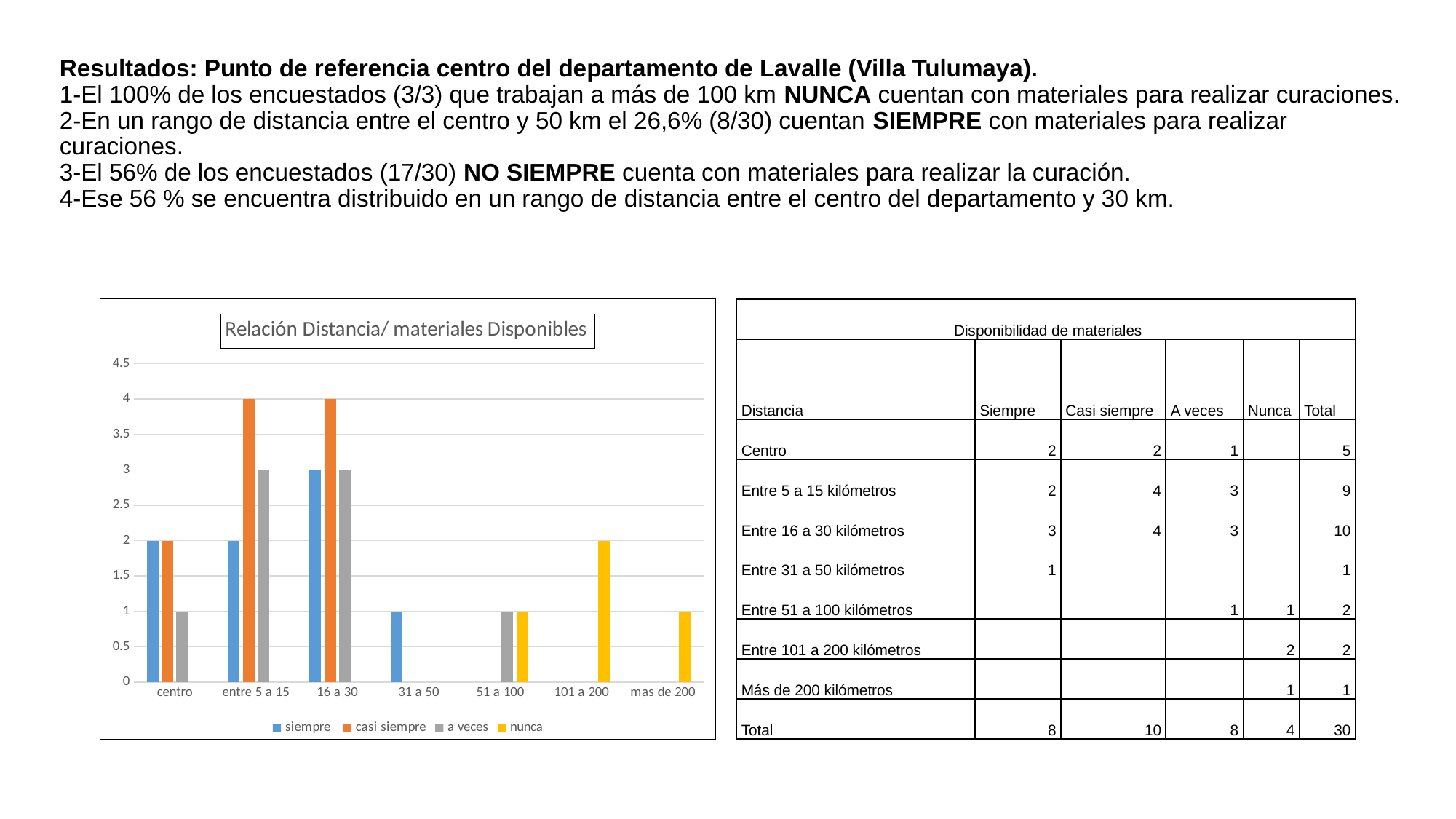
What is the value of the 'siempre' series for the '16 a 30' category? 3 How many series does the chart legend list? 4 Which is larger for the '16 a 30' category: the 'casi siempre' value or the 'a veces' value? casi siempre What is the value of the 'casi siempre' series for the 'entre 5 a 15' category? 4 Which category has the highest value for the 'siempre' series? 16 a 30 What is the title of the chart? Relación Distancia/ materiales Disponibles What is the difference between the 'casi siempre' value and the 'siempre' value for the 'entre 5 a 15' category? 2 What type of chart is shown on the slide? bar chart How many distance categories are shown on the x axis of the chart? 7 Which category has the highest value for the 'nunca' series? 101 a 200 What is the value of the 'a veces' series for the 'centro' category? 1 What is the value of the 'nunca' series for the '101 a 200' category? 2